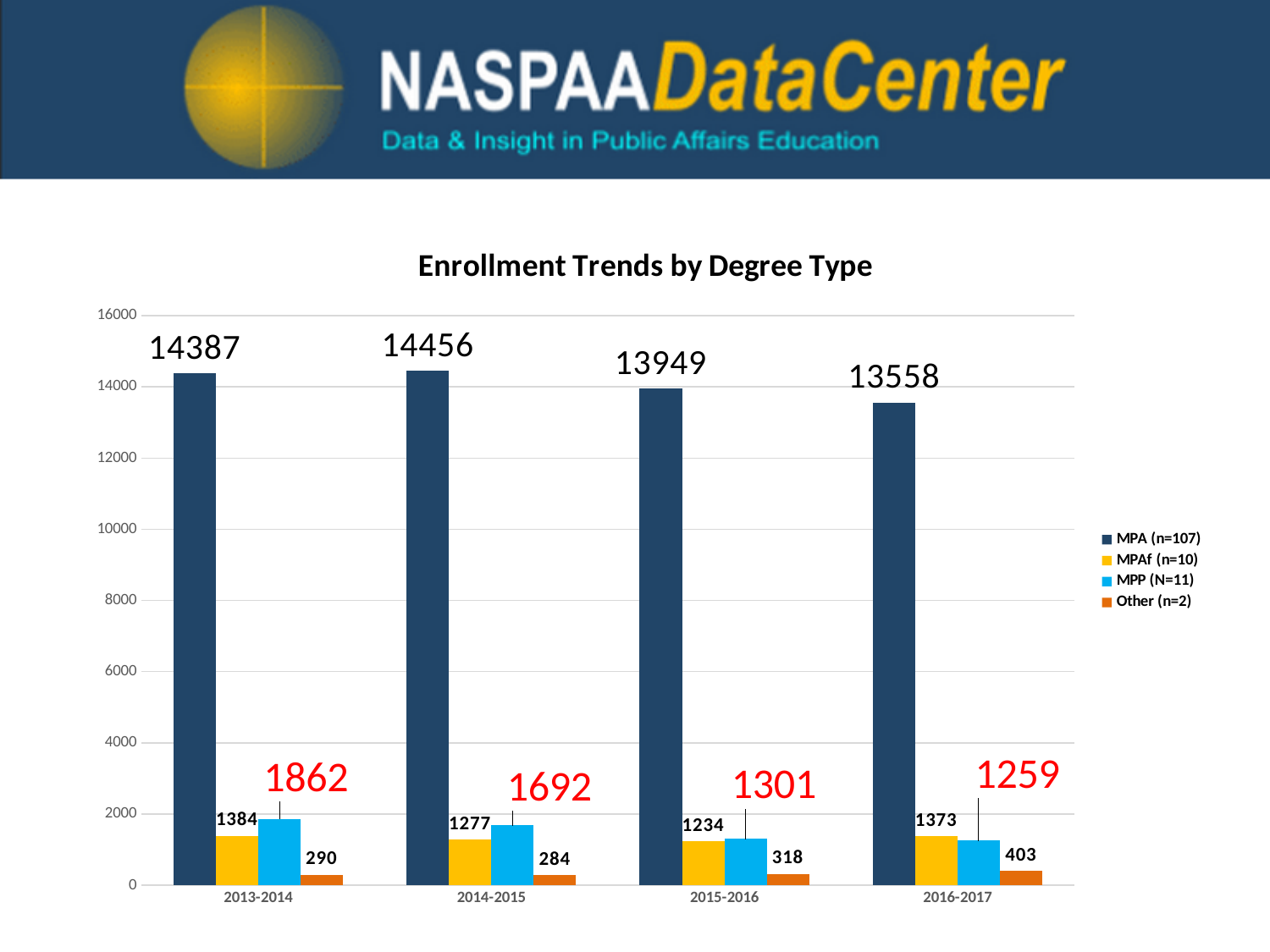
In which year is MPA enrollment highest? 2014-2015 What is the difference between MPA enrollment in 2013-2014 and 2016-2017? 829 What is the MPAf enrollment value for 2015-2016? 1234 What is the Other enrollment value for 2016-2017? 403 Does MPP enrollment rise or fall from 2013-2014 to 2016-2017? Fall What kind of chart is shown on the slide? Bar chart Which is larger: MPAf enrollment in 2016-2017 or MPP enrollment in 2016-2017? MPAf enrollment in 2016-2017 What is the MPA enrollment value for 2014-2015? 14456 What is the MPP enrollment value for 2013-2014? 1862 How many academic years are shown on the x axis? 4 In which year is MPP enrollment lowest? 2016-2017 How many series does the legend list? 4